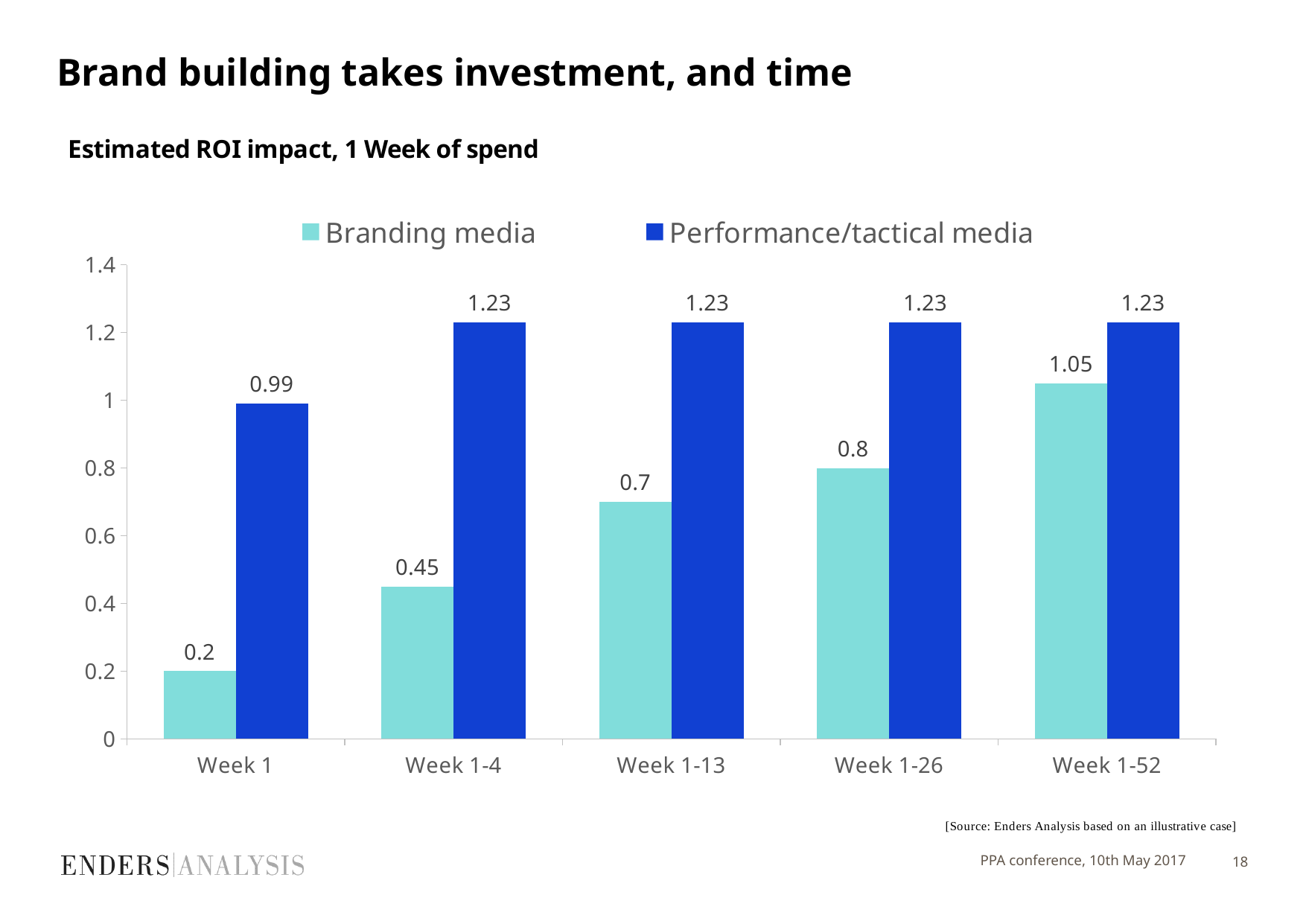
Is the Branding media value for Week 1-52 greater or less than 1? greater What is the difference between the Performance/tactical media and Branding media values for Week 1-4? 0.78 Which category has the highest Branding media value? Week 1-52 What is the Branding media value for Week 1-13? 0.7 Do the Branding media values rise or fall from Week 1 to Week 1-52? Rise What is the Branding media value for Week 1-52? 1.05 How many series does the legend list? 2 What is the Performance/tactical media value for Week 1? 0.99 How many categories are shown on the x axis? 5 Which category has the lowest Branding media value? Week 1 What kind of chart is shown on the slide? Bar chart Which is larger for Week 1-26: Branding media or Performance/tactical media? Performance/tactical media